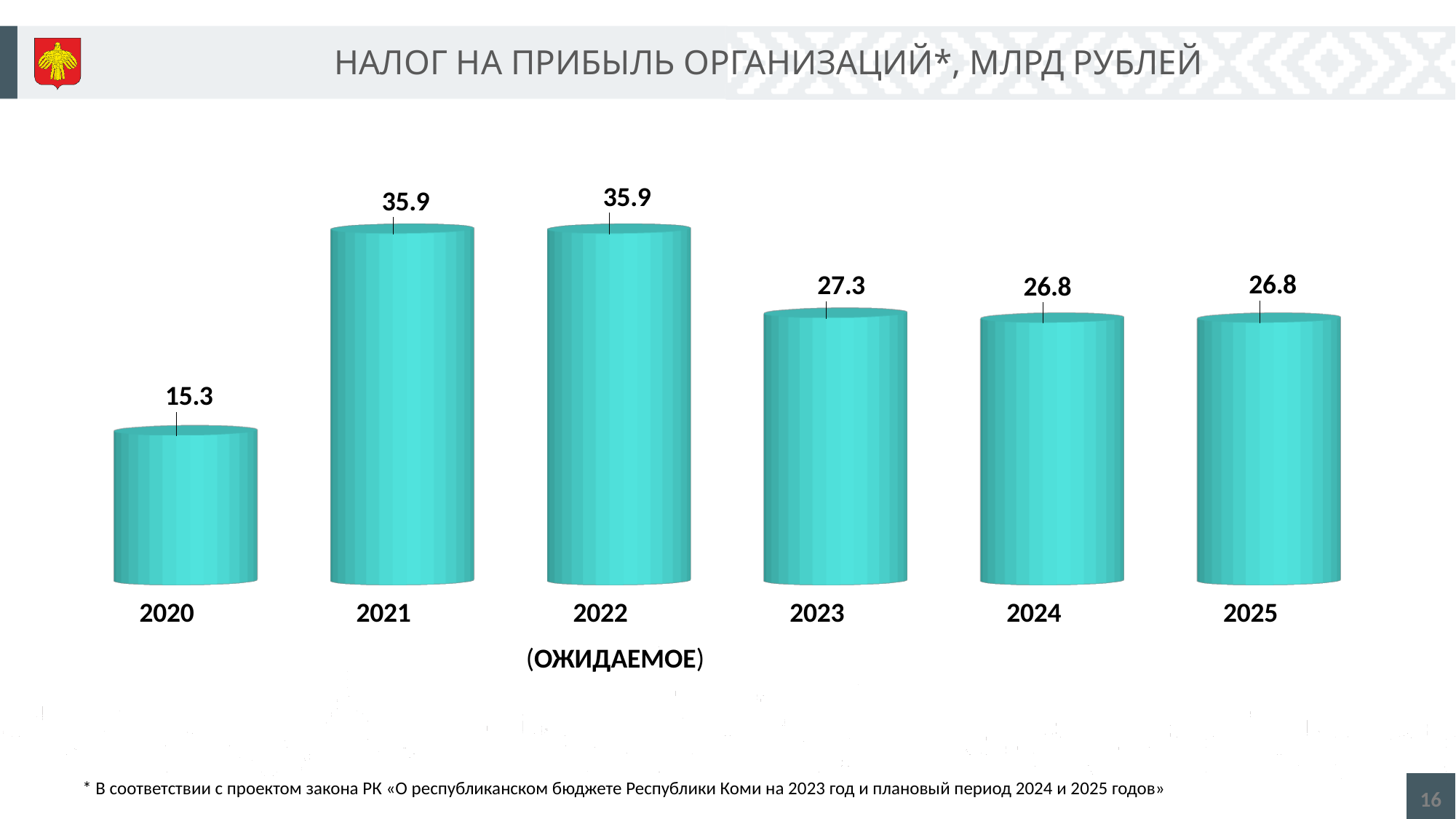
What is the value for 2023? 27.3 Which year has the lowest value? 2020 Which is larger, the value for 2020 or the value for 2025? 2025 What is the title of the chart? НАЛОГ НА ПРИБЫЛЬ ОРГАНИЗАЦИЙ*, МЛРД РУБЛЕЙ What is the difference between the values for 2021 and 2020? 20.6 Which is larger, the value for 2023 or the value for 2024? 2023 How many years are shown on the chart? 6 What is the value for 2020? 15.3 What is the difference between the values for 2022 and 2023? 8.6 What kind of chart is this? bar chart Do the values rise or fall from 2022 to 2023? fall What is the value for 2025? 26.8